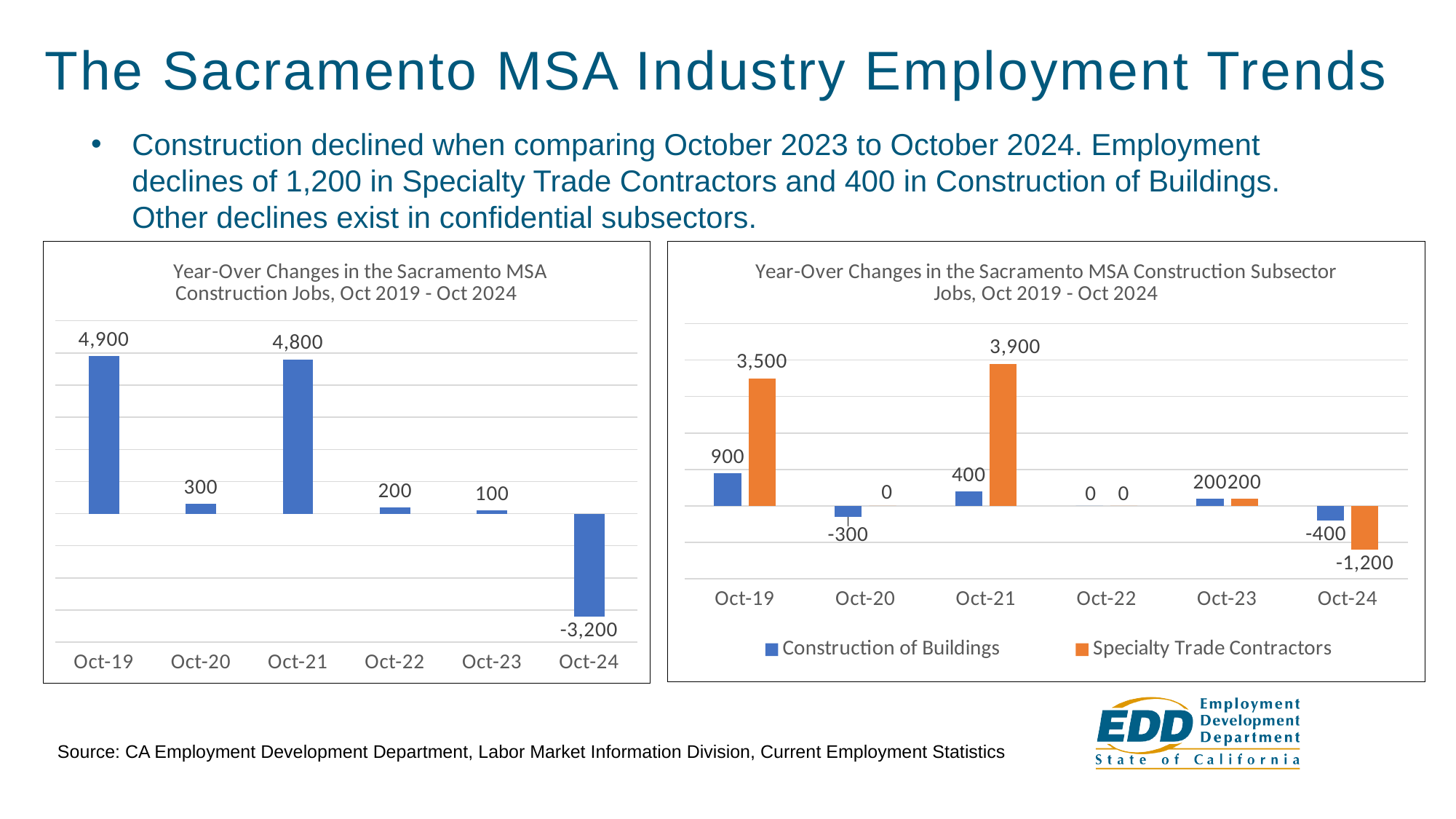
In the right chart (Construction Subsector Jobs), what is the difference between Specialty Trade Contractors and Construction of Buildings in Oct-24? 800 In the right chart (Construction Subsector Jobs), what is the value for Specialty Trade Contractors in Oct-21? 3,900 In the left chart (Year-Over Changes in the Sacramento MSA Construction Jobs), which period has the lowest value? Oct-24 What type of chart is the left chart (Year-Over Changes in the Sacramento MSA Construction Jobs)? Bar chart In the left chart (Year-Over Changes in the Sacramento MSA Construction Jobs), how many periods are shown on the x axis? 6 In the right chart (Construction Subsector Jobs), which is larger in Oct-19: Construction of Buildings or Specialty Trade Contractors? Specialty Trade Contractors In the left chart (Year-Over Changes in the Sacramento MSA Construction Jobs), what is the difference between the Oct-19 and Oct-21 values? 100 In the right chart (Construction Subsector Jobs), what is the value for Construction of Buildings in Oct-20? -300 In the left chart (Year-Over Changes in the Sacramento MSA Construction Jobs), what is the value for Oct-19? 4,900 In the left chart (Year-Over Changes in the Sacramento MSA Construction Jobs), what is the value for Oct-24? -3,200 In the left chart (Year-Over Changes in the Sacramento MSA Construction Jobs), which period has the highest value? Oct-19 In the right chart (Construction Subsector Jobs), how many series does the legend list? 2